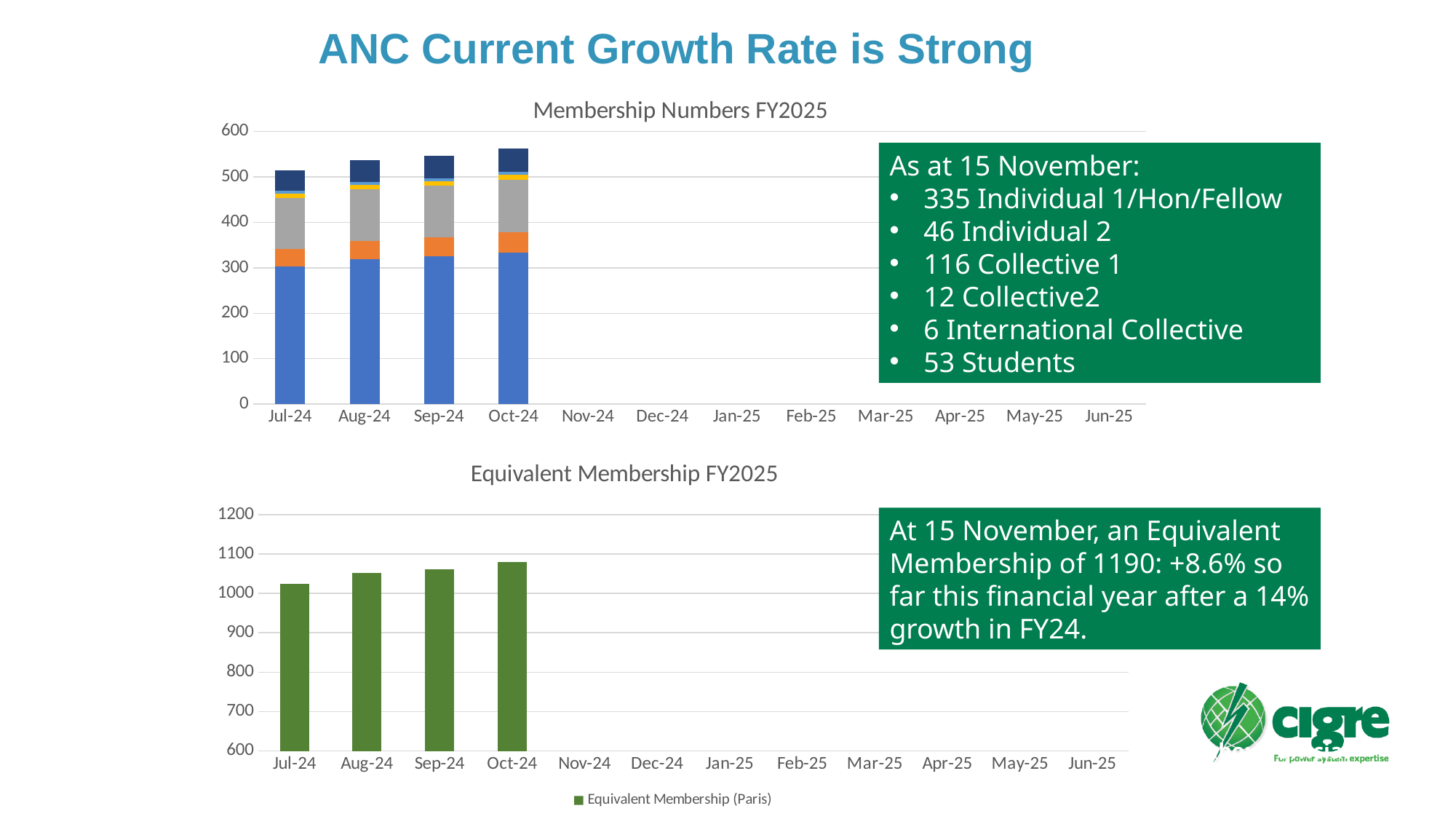
In the "Membership Numbers FY2025" chart, is the total for Oct-24 greater or less than 500? greater In the "Membership Numbers FY2025" chart, how many months have bars plotted? 4 In the "Membership Numbers FY2025" chart, which month has the tallest stacked bar? Oct-24 In the "Equivalent Membership FY2025" chart, is the value for Oct-24 greater or less than 1000? greater In the "Membership Numbers FY2025" chart, do the stacked bar totals rise or fall from Jul-24 to Oct-24? rise In the "Equivalent Membership FY2025" chart, which plotted month has the highest value? Oct-24 In the "Equivalent Membership FY2025" chart, how many month categories are shown on the x axis? 12 How many series does the legend of the "Equivalent Membership FY2025" chart list, and what is it called? 1, Equivalent Membership (Paris) In the "Membership Numbers FY2025" chart, which plotted month has the shortest stacked bar? Jul-24 What kind of chart is the "Membership Numbers FY2025" chart? Stacked bar chart What kind of chart is the "Equivalent Membership FY2025" chart? Bar chart In the "Equivalent Membership FY2025" chart, is the value for Jul-24 greater or less than 1100? less